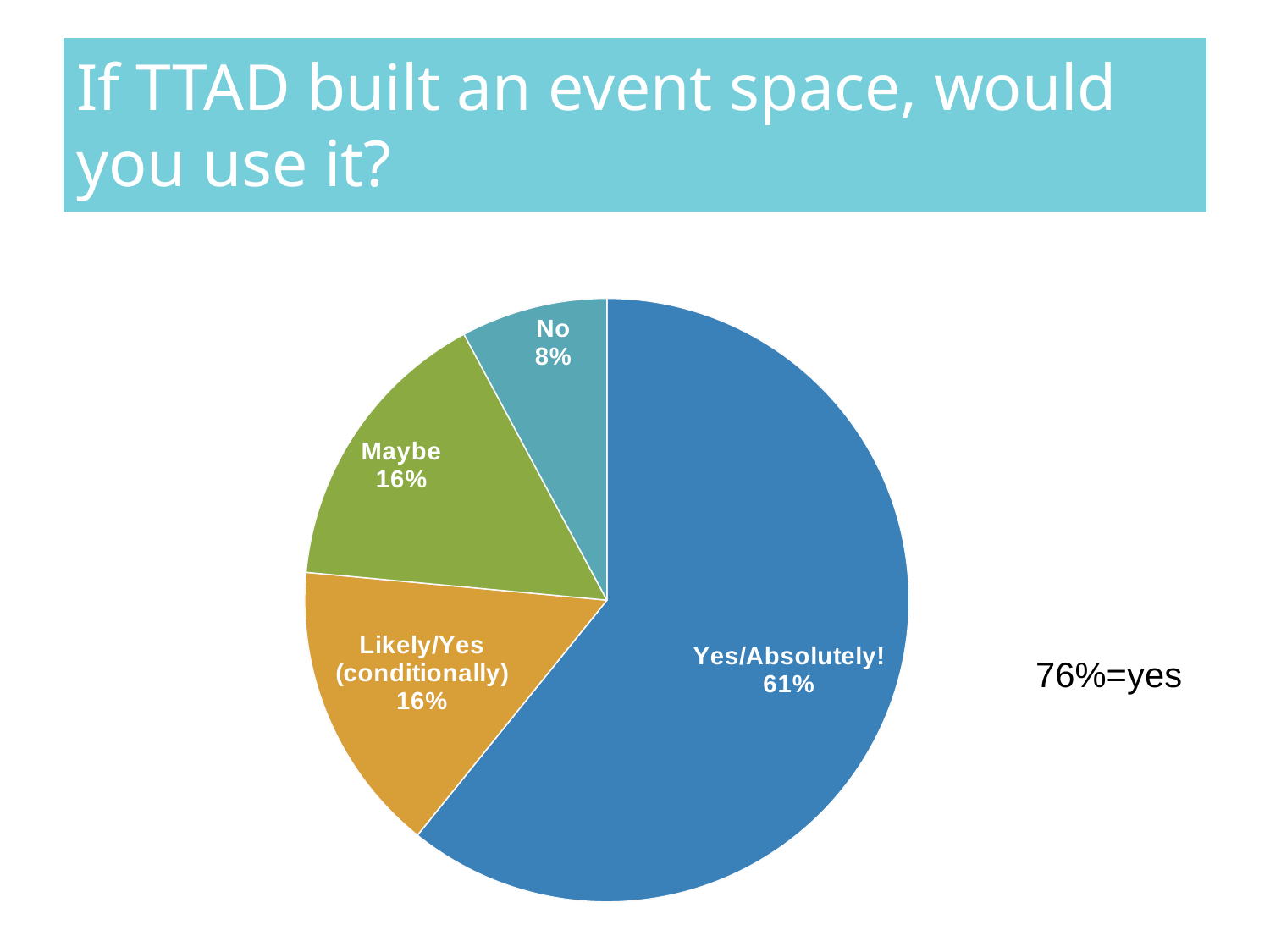
What share of the pie is labelled Likely/Yes (conditionally)? 16% What is the difference in percentage points between the Yes/Absolutely! slice and the Maybe slice? 45 Which is larger, the Maybe slice or the No slice? Maybe Which slice of the pie is the largest? Yes/Absolutely! What kind of chart is shown on the slide? Pie chart What share of the pie is labelled Yes/Absolutely!? 61% What share of the pie is labelled Maybe? 16% Which slice of the pie is the smallest? No What is the combined share of the Yes/Absolutely! and Likely/Yes (conditionally) slices? 77% What colour is the Yes/Absolutely! slice? Blue How many slices does the pie chart have? 4